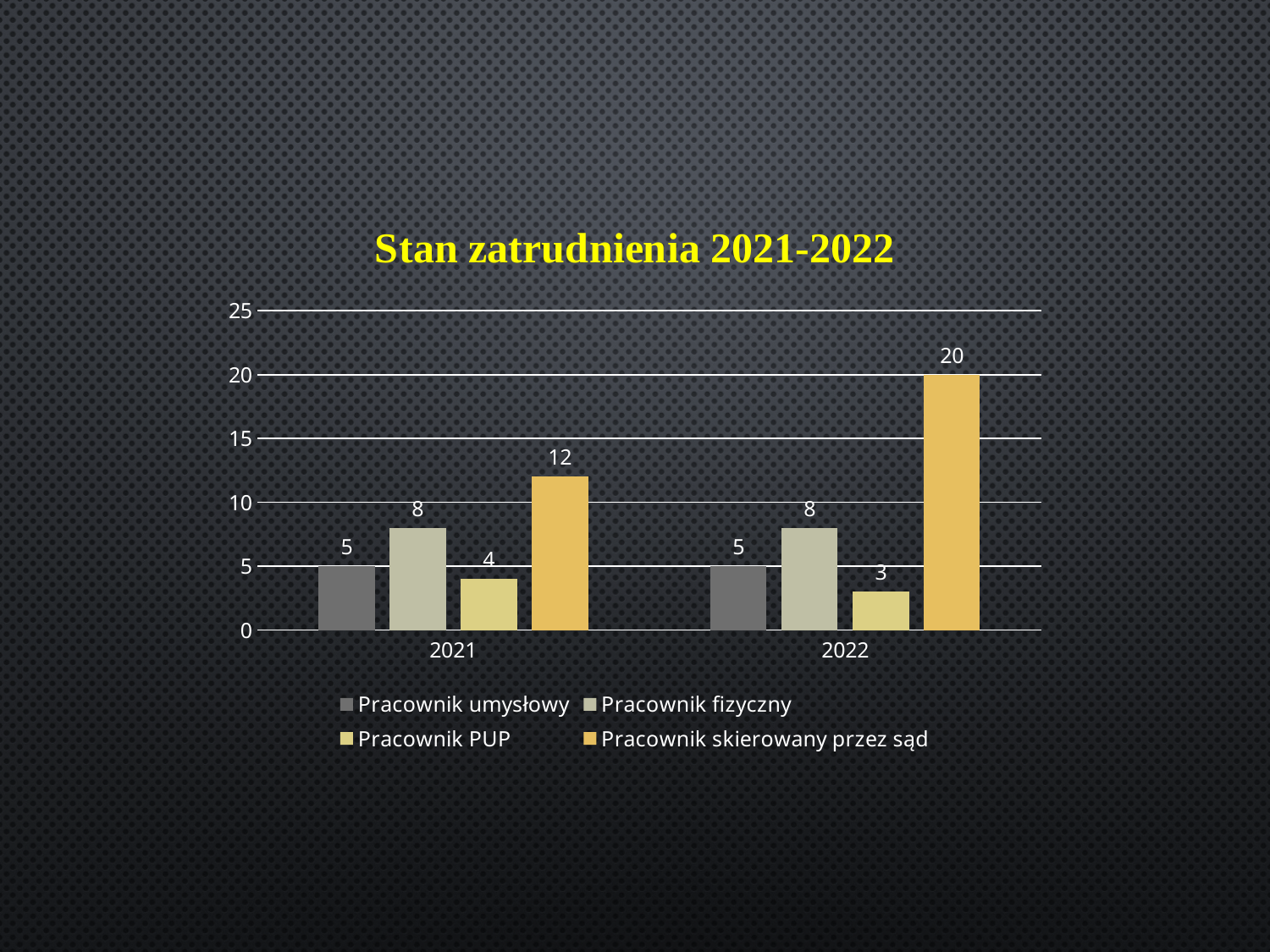
Which series has the highest value in 2022? Pracownik skierowany przez sąd Which series has the lowest value in 2022? Pracownik PUP What is the title of the chart? Stan zatrudnienia 2021-2022 What is the value for Pracownik umysłowy in 2021? 5 What is the value for Pracownik fizyczny in 2022? 8 What kind of chart is shown on the slide? Bar chart What is the difference between the Pracownik skierowany przez sąd values for 2022 and 2021? 8 How many series does the legend list? 4 What is the value for Pracownik PUP in 2021? 4 Which is larger: Pracownik PUP in 2021 or Pracownik PUP in 2022? Pracownik PUP in 2021 How many categories are shown on the x axis? 2 What is the value for Pracownik skierowany przez sąd in 2022? 20